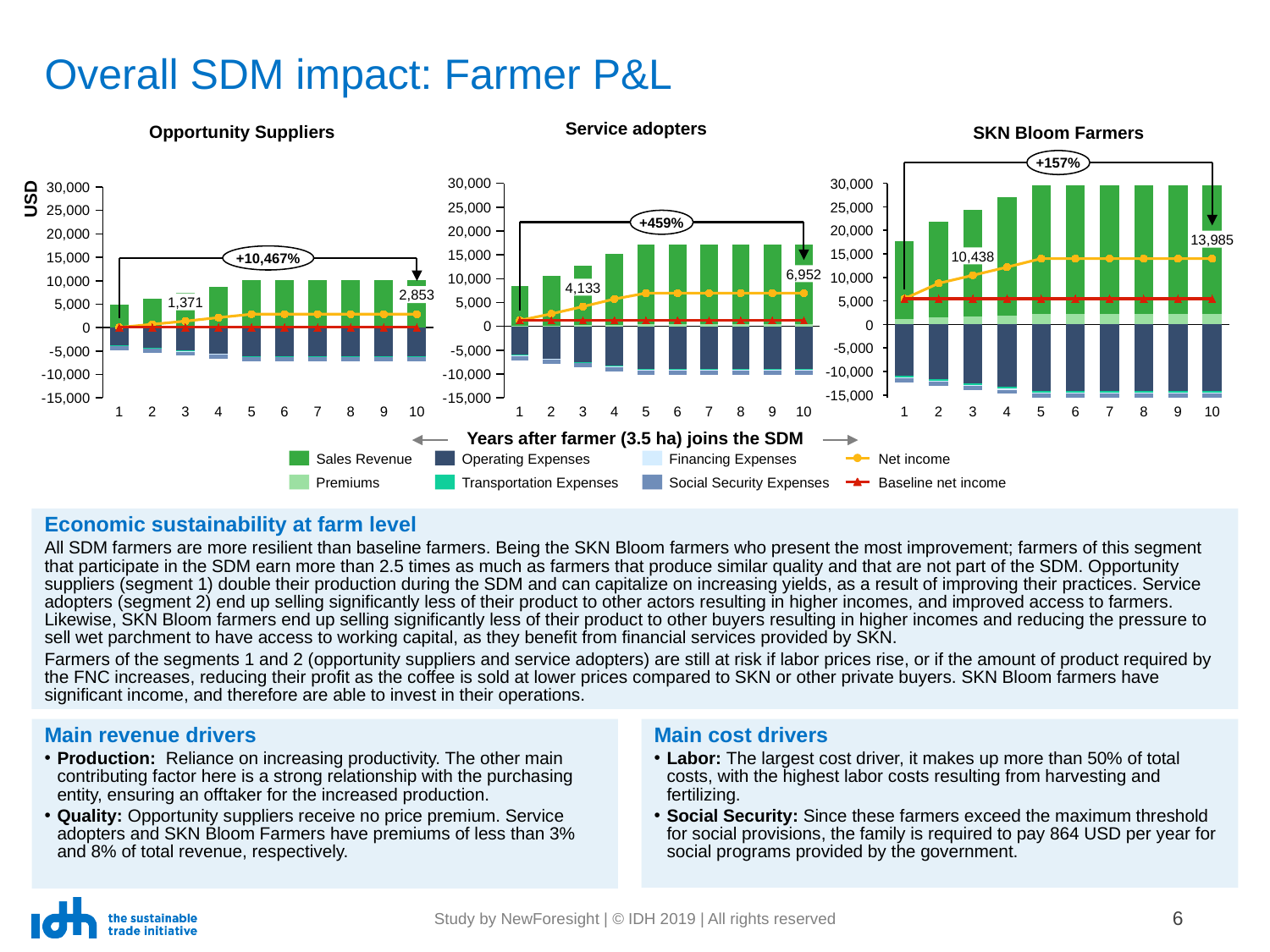
How many years are shown on the x axis of each chart? 10 In the Opportunity Suppliers chart, what is the labelled net income in year 10? 2,853 In the SKN Bloom Farmers chart, what is the labelled net income in year 10? 13,985 In the SKN Bloom Farmers chart, is the Sales Revenue bar in year 1 greater or less than 15,000? greater In the Service adopters chart, does the Net income line rise or fall from year 1 to year 10? Rise What kind of chart is used for the Opportunity Suppliers panel? Combination stacked bar and line chart In the SKN Bloom Farmers chart, what is the difference between the labelled net income in year 10 and in year 3? 3,547 What percentage increase is labelled on the Opportunity Suppliers chart? +10,467% Which chart shows the higher labelled net income in year 10, Service adopters or SKN Bloom Farmers? SKN Bloom Farmers In the Service adopters chart, what is the labelled net income in year 3? 4,133 How many series does the shared legend list? 8 In the Service adopters chart, by how much does the labelled net income in year 10 exceed that in year 3? 2,819